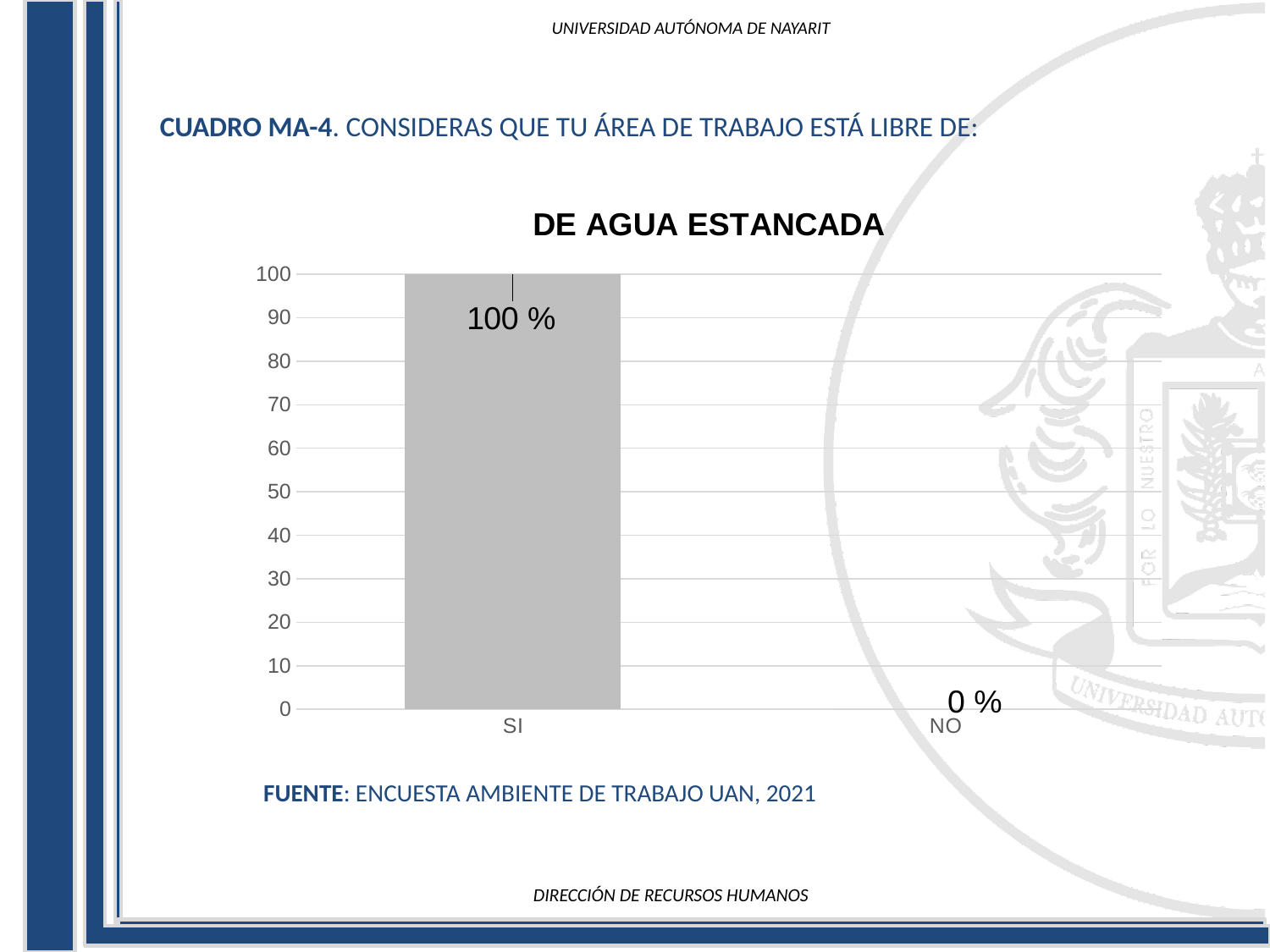
What is the difference between the values for SI and NO? 100 % How many categories are shown on the x axis? 2 Which category has the highest value? SI What is the value for SI? 100 % What kind of chart is shown? bar chart Which is larger, the value for SI or the value for NO? SI Do the values rise or fall from SI to NO? fall What is the title of the chart? DE AGUA ESTANCADA Is the value for SI greater or less than 50? greater What is the value for NO? 0 % What is the highest value shown on the y axis? 100 Which category has the lowest value? NO